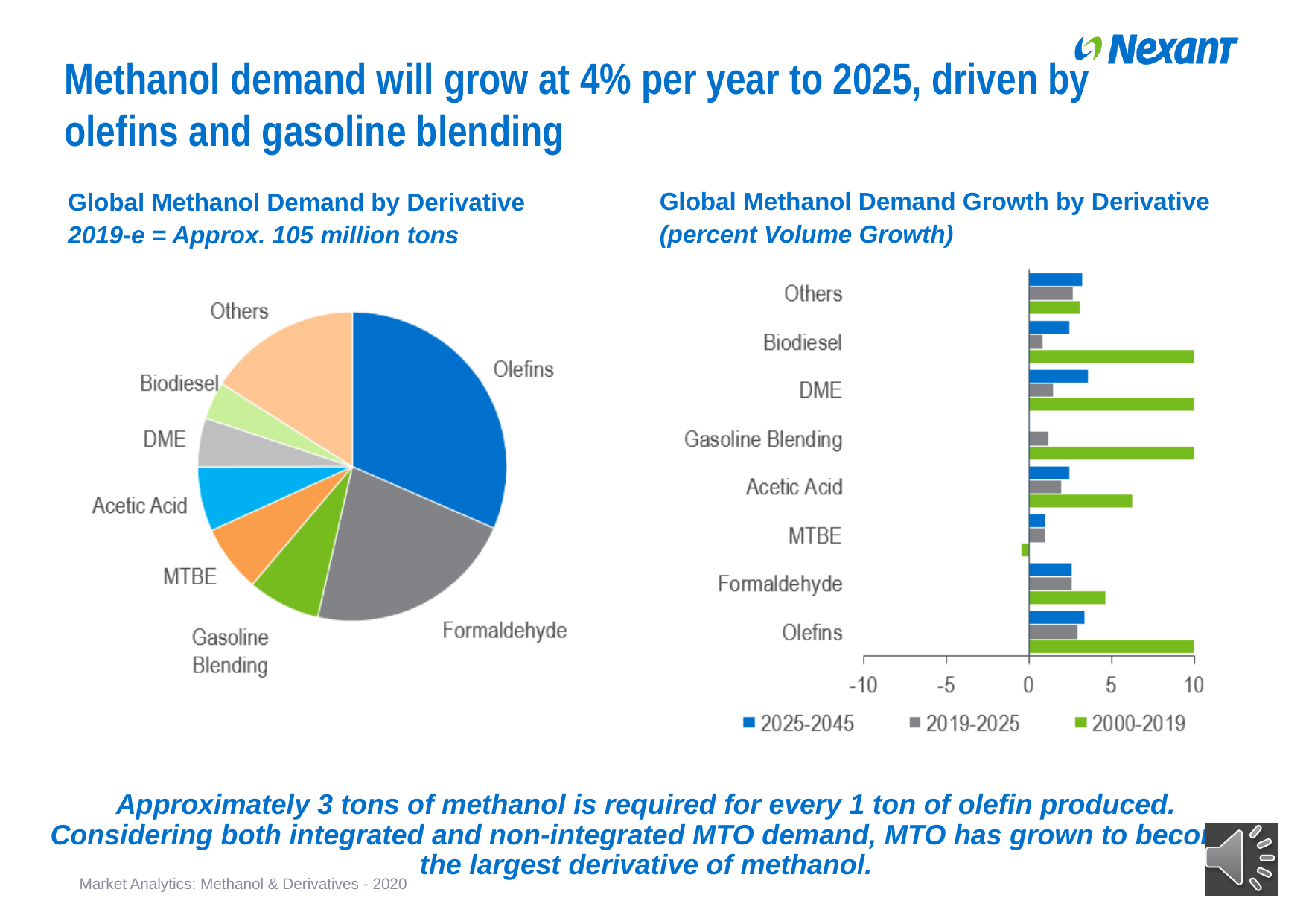
In the Global Methanol Demand by Derivative pie chart, which slice is larger, Olefins or Formaldehyde? Olefins In the Global Methanol Demand by Derivative pie chart, which derivative has the largest share? Olefins How many series does the legend of the Global Methanol Demand Growth by Derivative chart list? 3 In the Global Methanol Demand Growth by Derivative chart, is the 2025-2045 value for Others greater or less than 5? less What kind of chart is the Global Methanol Demand Growth by Derivative chart on the right? Bar chart What kind of chart is the Global Methanol Demand by Derivative chart on the left? Pie chart In the Global Methanol Demand Growth by Derivative chart, is the 2000-2019 value for MTBE greater or less than 0? less In the Global Methanol Demand Growth by Derivative chart, which series is shown in green? 2000-2019 In the Global Methanol Demand Growth by Derivative chart, which derivative has the lowest 2000-2019 growth? MTBE In the Global Methanol Demand Growth by Derivative chart, is the 2000-2019 value for Acetic Acid greater or less than 5? greater In the Global Methanol Demand by Derivative pie chart, how many derivative categories are shown? 8 In the Global Methanol Demand Growth by Derivative chart, which is larger for Gasoline Blending, the 2000-2019 value or the 2019-2025 value? 2000-2019